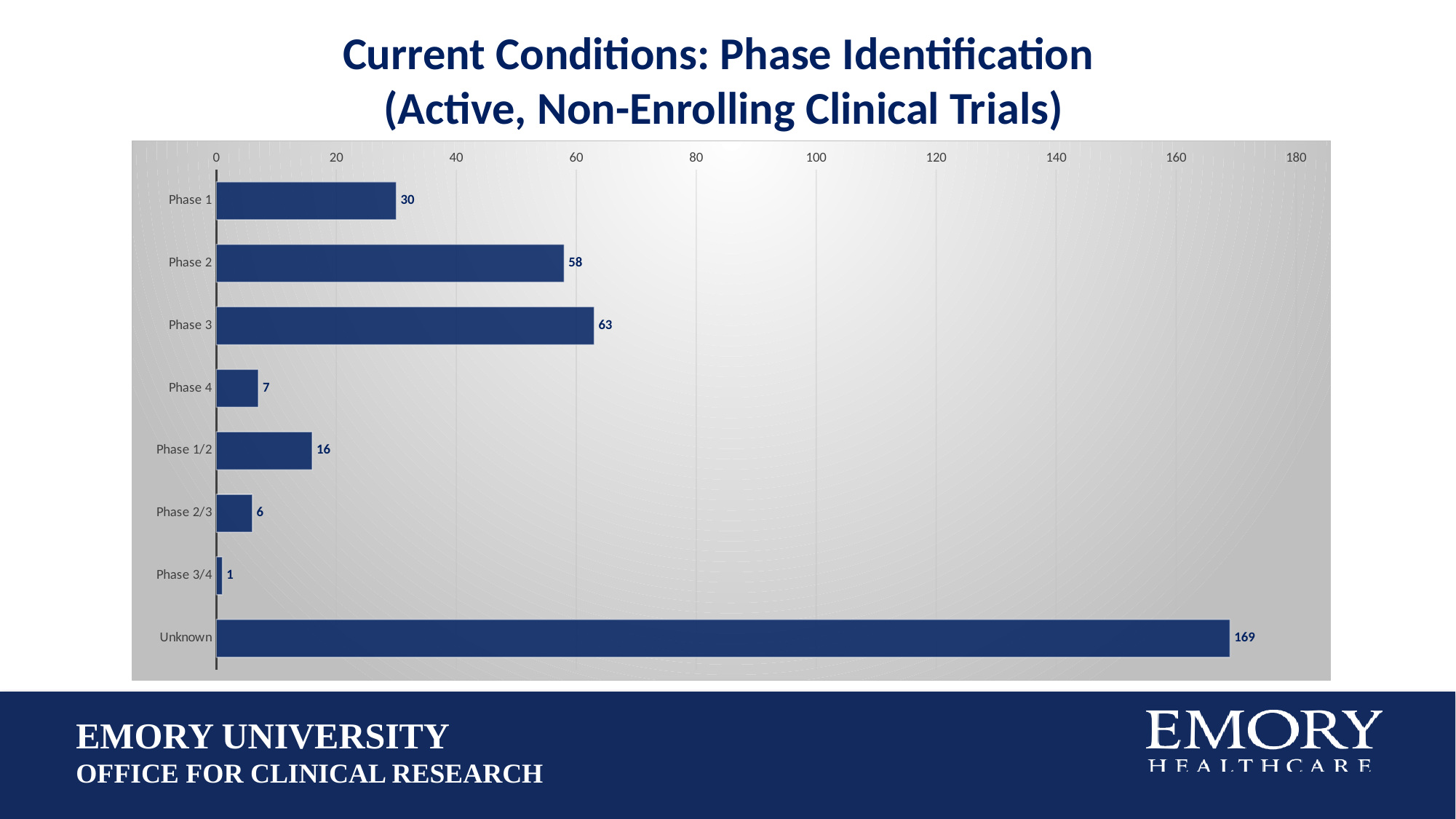
What is the value for Phase 1/2? 16 What is the difference between the values for Unknown and Phase 1? 139 Which category has the highest value? Unknown How many categories are shown in the chart? 8 What is the title of the chart? Current Conditions: Phase Identification (Active, Non-Enrolling Clinical Trials) Which is larger, the value for Phase 4 or the value for Phase 2/3? Phase 4 What is the value for Phase 3? 63 What is the difference between the values for Phase 3 and Phase 2? 5 What is the value for Unknown? 169 What kind of chart is shown on the slide? bar chart Is the value for Phase 2 greater or less than 40? greater Which category has the lowest value? Phase 3/4